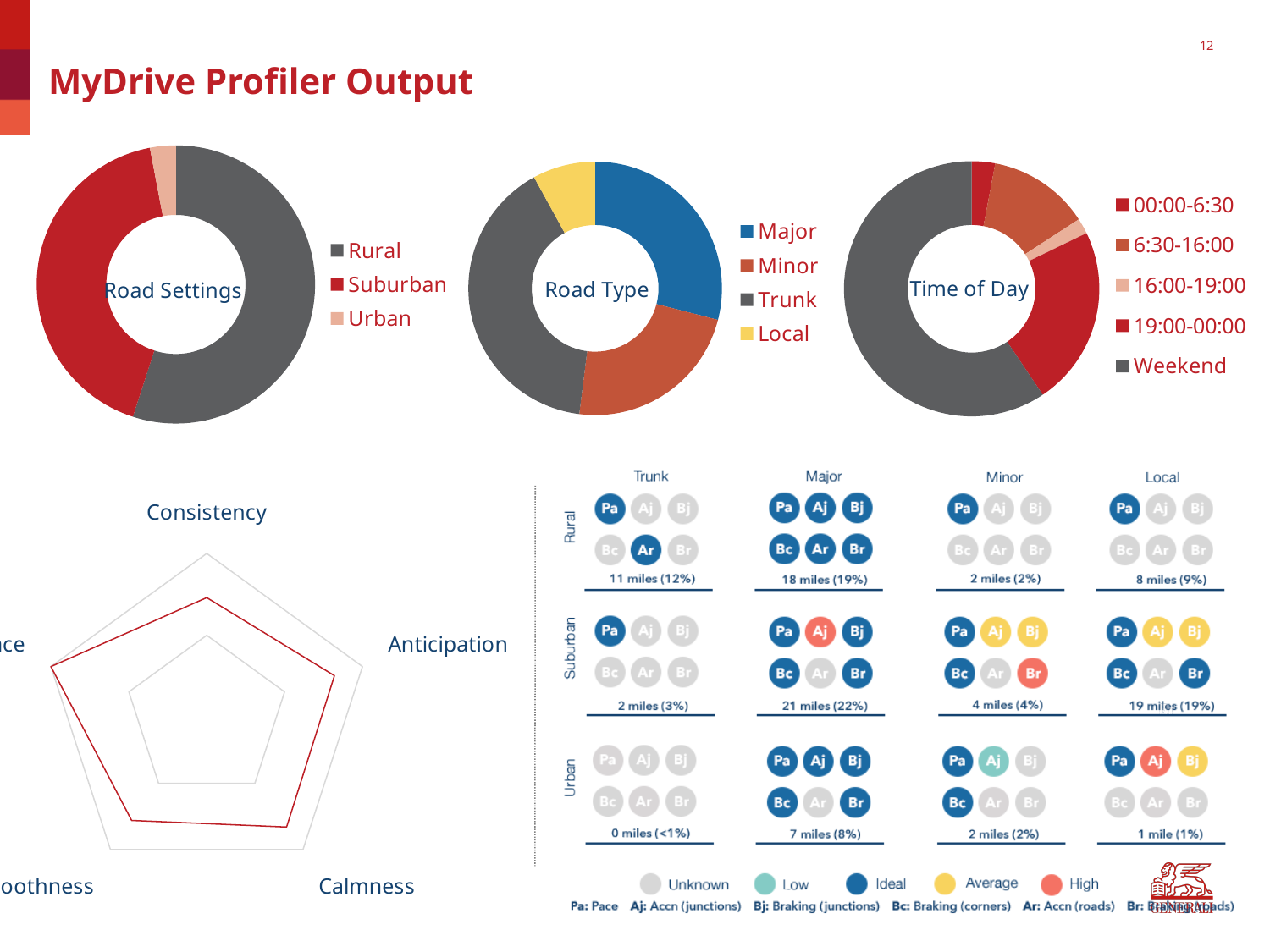
In the Road Settings chart, which category has the largest share? Rural How many categories does the legend of the Time of Day chart list? 5 What kind of chart is the Road Settings chart? Doughnut chart In the Road Type chart, which category has the smallest share? Local In the grid at the bottom right, how many miles are shown for Suburban Major roads? 21 miles (22%) What kind of chart is the chart at the bottom left with the axes Consistency, Anticipation and Calmness? Radar chart How many categories does the legend of the Road Settings chart list? 3 How many categories does the legend of the Road Type chart list? 4 In the Time of Day chart, which has the larger share, Weekend or 6:30-16:00? Weekend In the Time of Day chart, which category has the largest share? Weekend In the Road Settings chart, which category has the smallest share? Urban In the Road Type chart, which has the larger share, Major or Local? Major